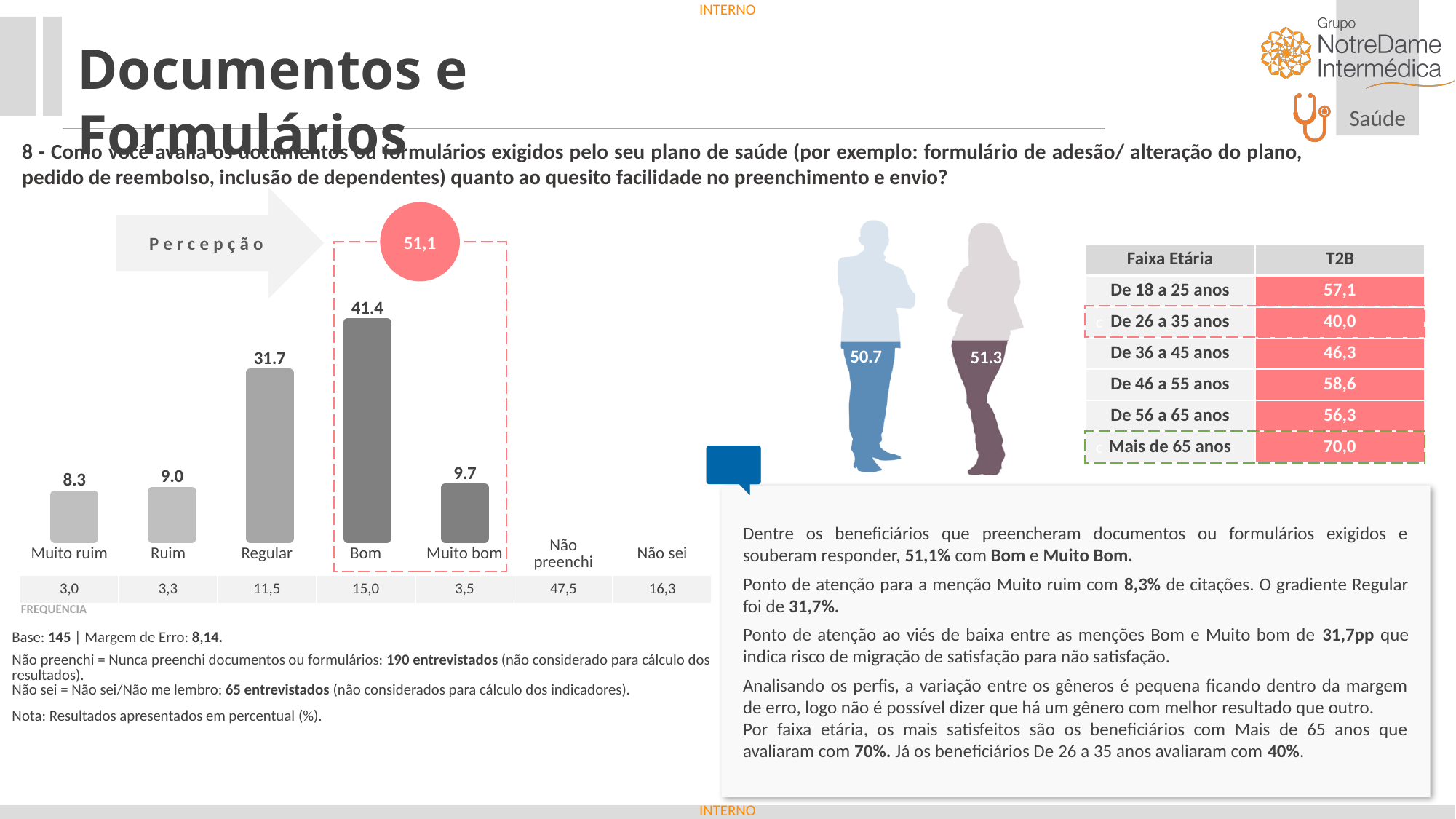
Which is larger, the value for 'Regular' or the value for 'Muito bom'? Regular What is the difference between the 'Bom' and 'Regular' values? 9.7 What is the value shown for the 'Regular' bar? 31.7 How many bars are plotted in the chart? 5 What is the value shown for the 'Muito bom' bar? 9.7 Which category has the lowest bar in the chart? Muito ruim What is the value shown for the 'Muito ruim' bar? 8.3 What is the value shown for the 'Bom' bar? 41.4 What is the difference between the 'Bom' and 'Muito bom' values? 31.7 Which category has the highest bar in the chart? Bom What value is shown in the red circle above the dashed box around 'Bom' and 'Muito bom'? 51,1 What type of chart is used to show the evaluation of documents and forms? bar chart